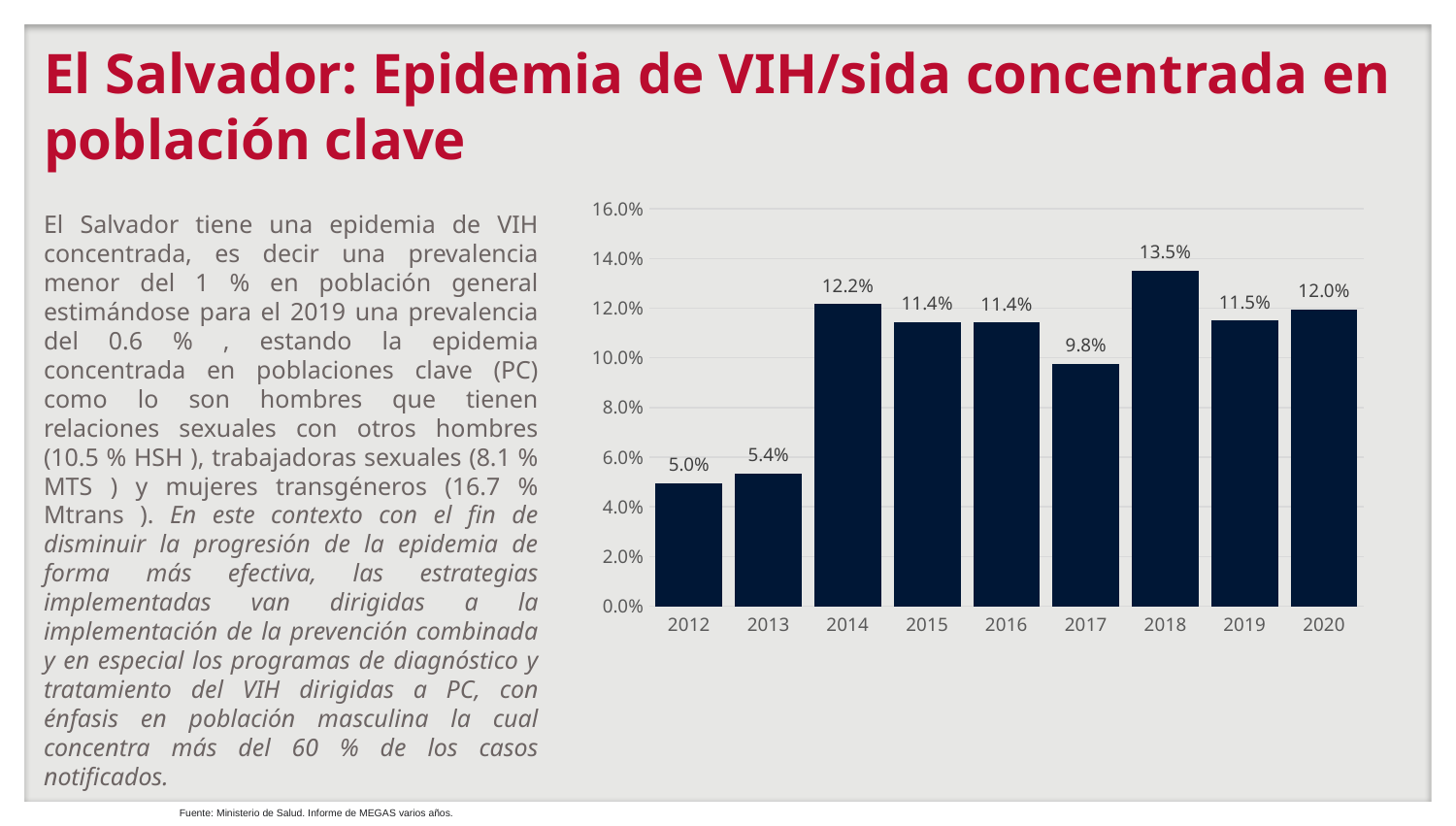
What is the value for 2017? 9.8% Which is larger, the value for 2020 or the value for 2019? 2020 How many years are shown on the x axis? 9 What is the value for 2018? 13.5% Which year has the lowest value? 2012 What is the difference between the values for 2014 and 2013? 6.8% What is the value for 2012? 5.0% What kind of chart is shown on the slide? bar chart Which year has the highest value? 2018 What is the difference between the values for 2018 and 2017? 3.7% Do the values generally rise or fall from 2012 to 2018? rise Is the value for 2016 greater or less than 10.0%? greater